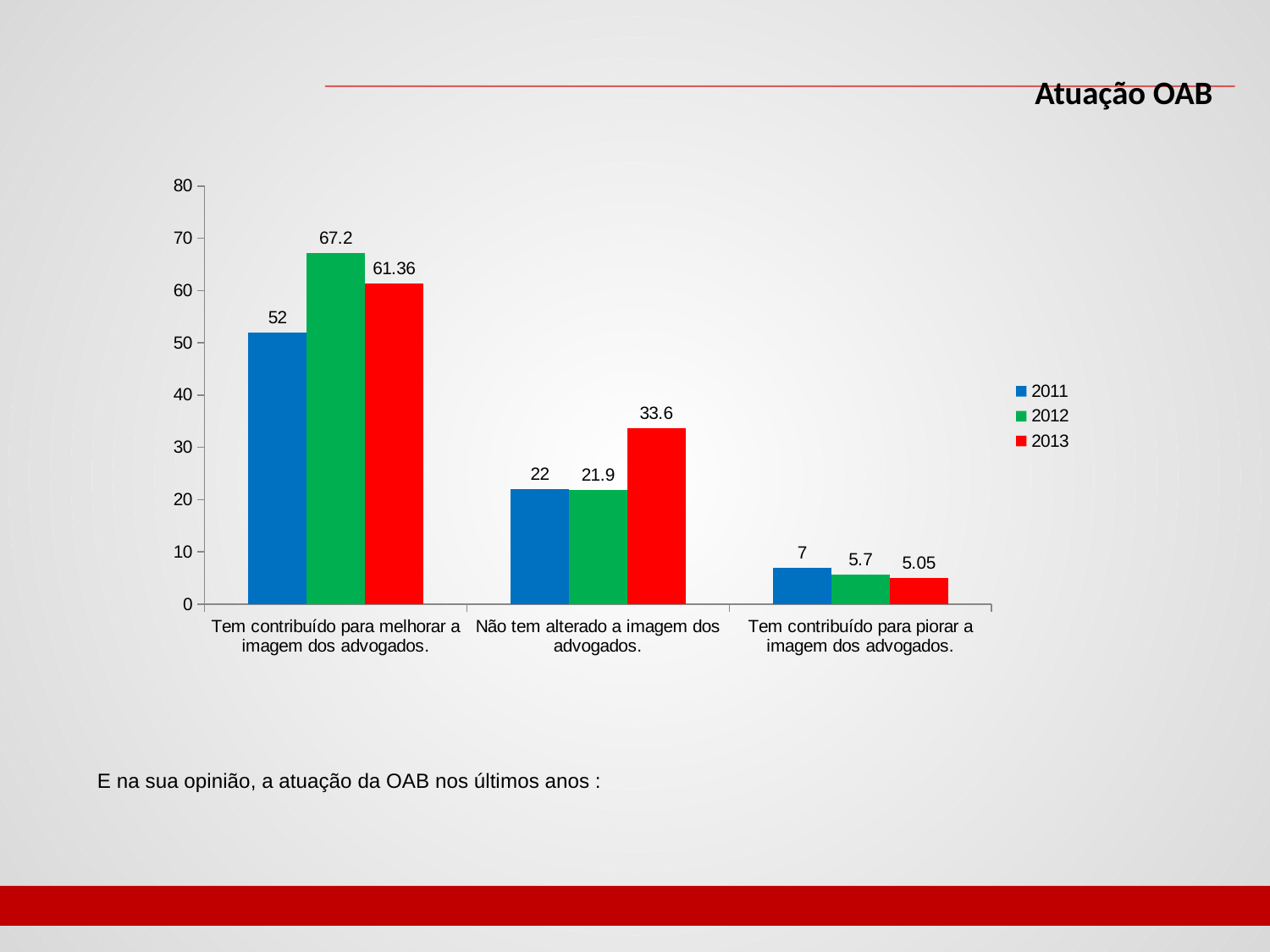
What is the 2013 value for "Não tem alterado a imagem dos advogados."? 33.6 How many categories are shown on the x axis? 3 Which year has the highest value for "Tem contribuído para melhorar a imagem dos advogados."? 2012 How many series does the legend list? 3 Which category has the lowest 2013 value? Tem contribuído para piorar a imagem dos advogados. What is the 2012 value for "Tem contribuído para melhorar a imagem dos advogados."? 67.2 Which is larger: the 2011 value or the 2013 value for "Não tem alterado a imagem dos advogados."? 2013 What is the 2011 value for "Tem contribuído para piorar a imagem dos advogados."? 7 Which colour represents the 2013 series in the legend? red Is the 2011 value for "Tem contribuído para melhorar a imagem dos advogados." greater or less than 40? greater What kind of chart is shown on the slide? bar chart What is the difference between the 2012 and 2013 values for "Tem contribuído para melhorar a imagem dos advogados."? 5.84